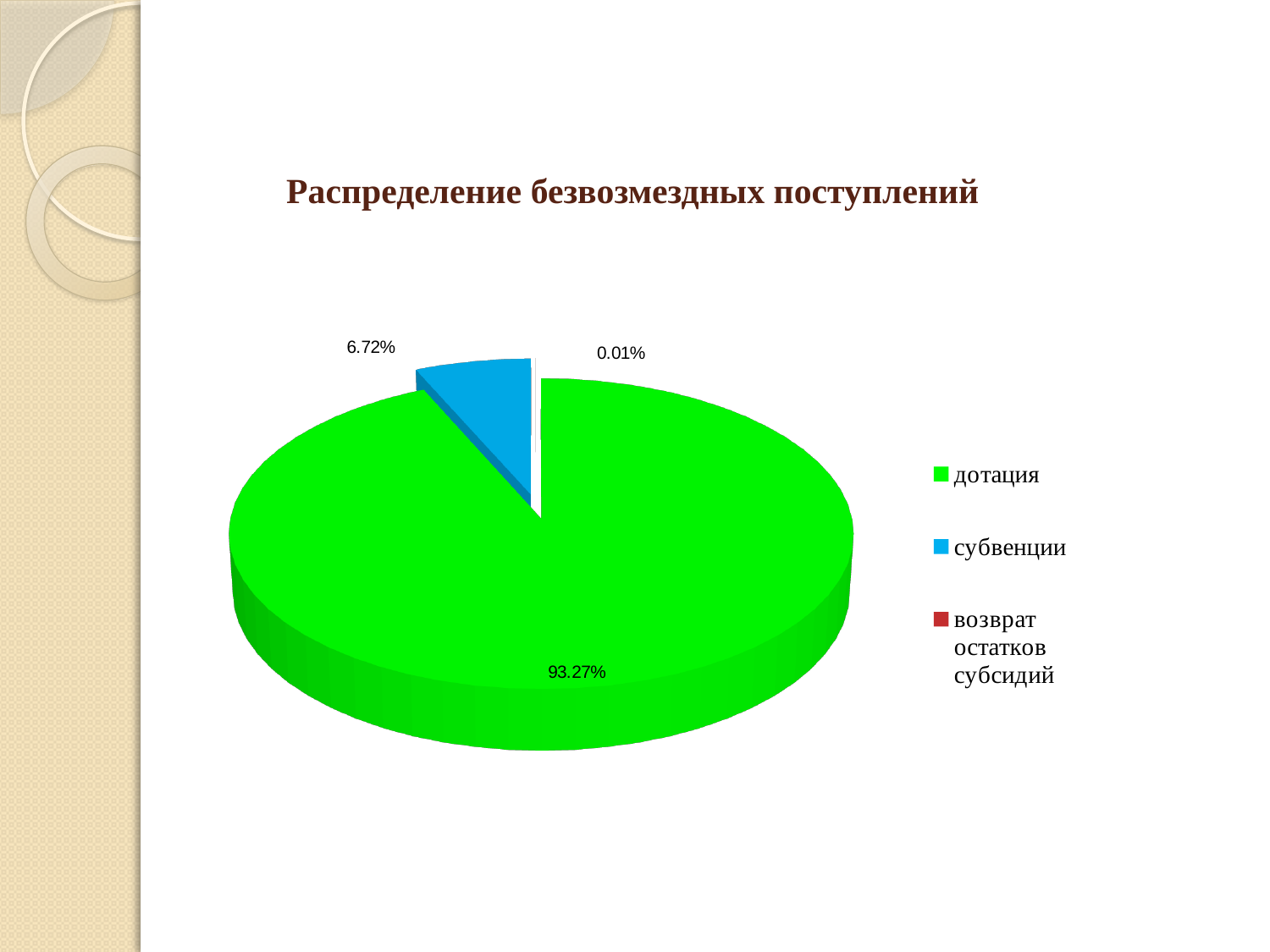
What colour is the slice for субвенции? blue What is the title of the chart? Распределение безвозмездных поступлений How many categories does the legend list? 3 What is the difference in percentage points between the share for дотация and the share for субвенции? 86.55 What share of the pie does дотация have? 93.27% Which category has the smallest share of the pie? возврат остатков субсидий Is the share for дотация greater or less than 90%? greater Which category has the largest share of the pie? дотация What share of the pie does возврат остатков субсидий have? 0.01% What kind of chart is shown on the slide? pie chart Which is larger, the share for субвенции or the share for возврат остатков субсидий? субвенции What share of the pie does субвенции have? 6.72%